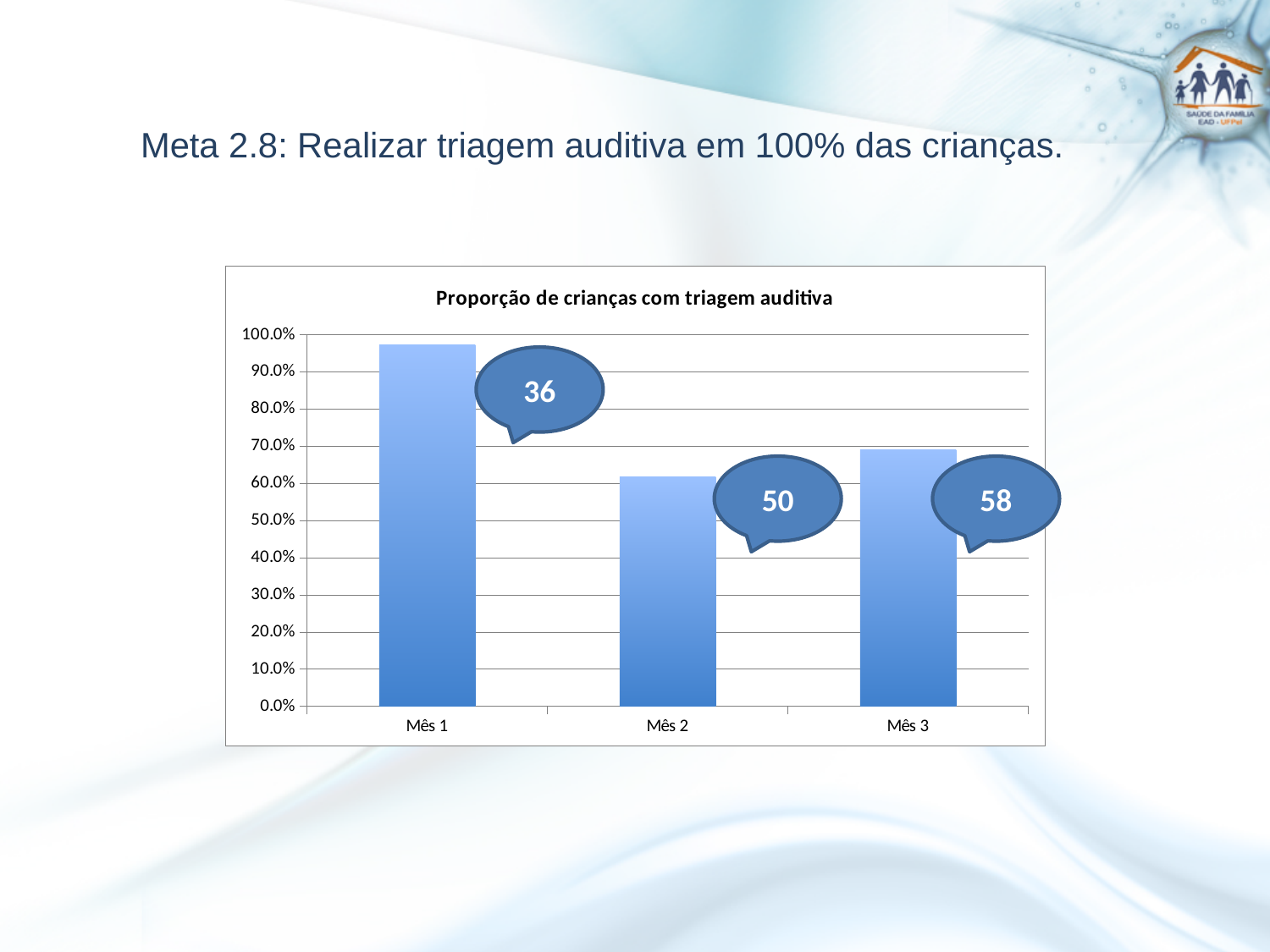
What kind of chart is shown on the slide? bar chart Is the value for Mês 1 greater or less than 100.0%? less What number is shown in the callout bubble next to the Mês 2 bar? 50 Which month has the highest proportion of children with hearing screening? Mês 1 Is the value for Mês 1 greater or less than 90.0%? greater Which has a larger value, Mês 2 or Mês 3? Mês 3 Does the value rise or fall from Mês 1 to Mês 2? fall Which month has the lowest proportion of children with hearing screening? Mês 2 How many months (categories) are plotted on the x axis? 3 What is the title of the chart? Proporção de crianças com triagem auditiva Is the value for Mês 3 greater or less than 60.0%? greater